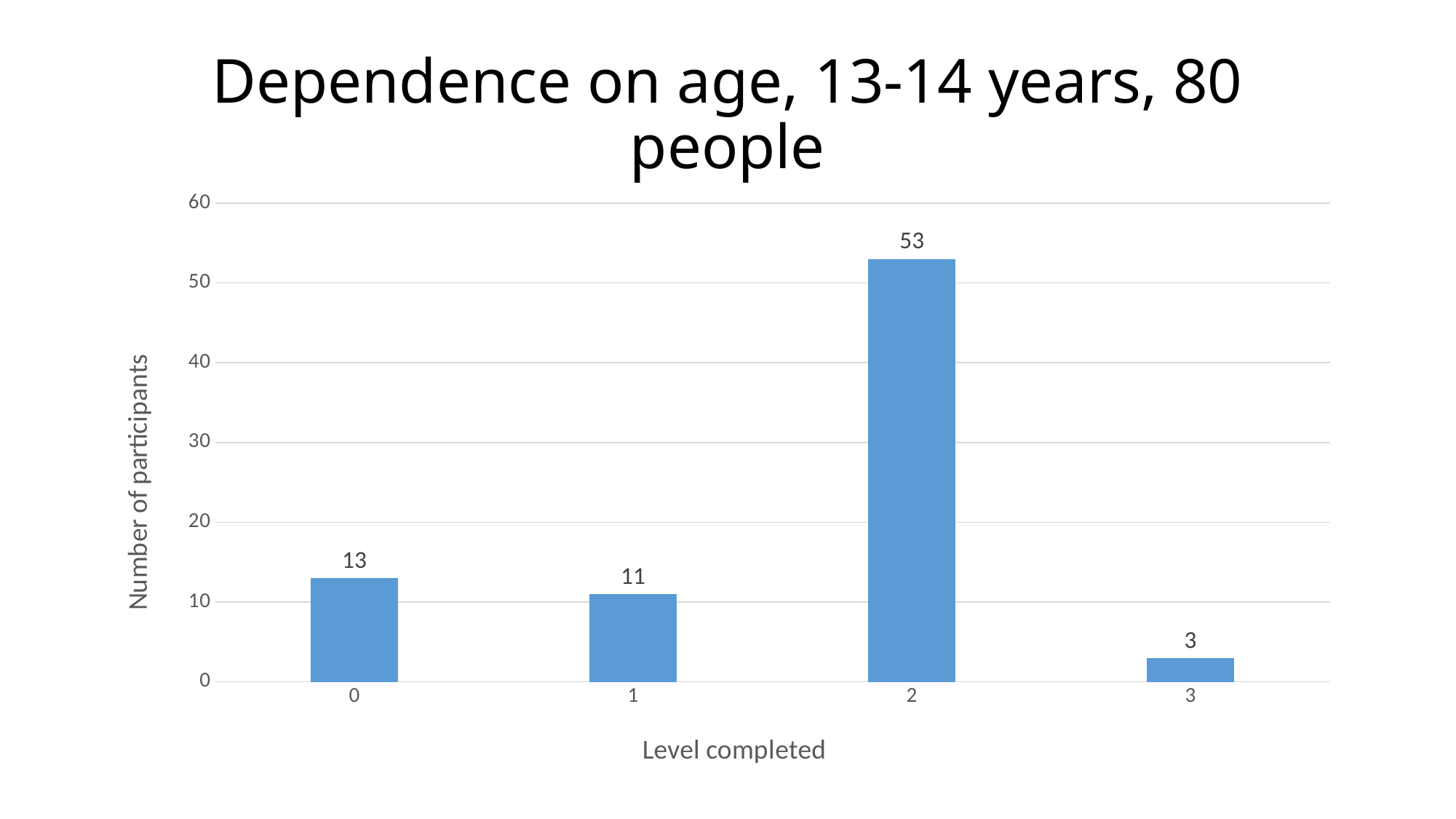
What is the difference in number of participants between level 2 and level 0? 40 What is the number of participants for level completed 3? 3 What is the title of the chart? Dependence on age, 13-14 years, 80 people What is the difference in number of participants between level 0 and level 1? 2 How many level categories are shown on the x axis? 4 What is the number of participants for level completed 2? 53 Which has more participants, level 1 or level 3? Level 1 Which level completed has the highest number of participants? 2 Which level completed has the lowest number of participants? 3 What is the number of participants for level completed 0? 13 What kind of chart is shown on the slide? Bar chart Is the value for level 2 greater or less than 50? greater